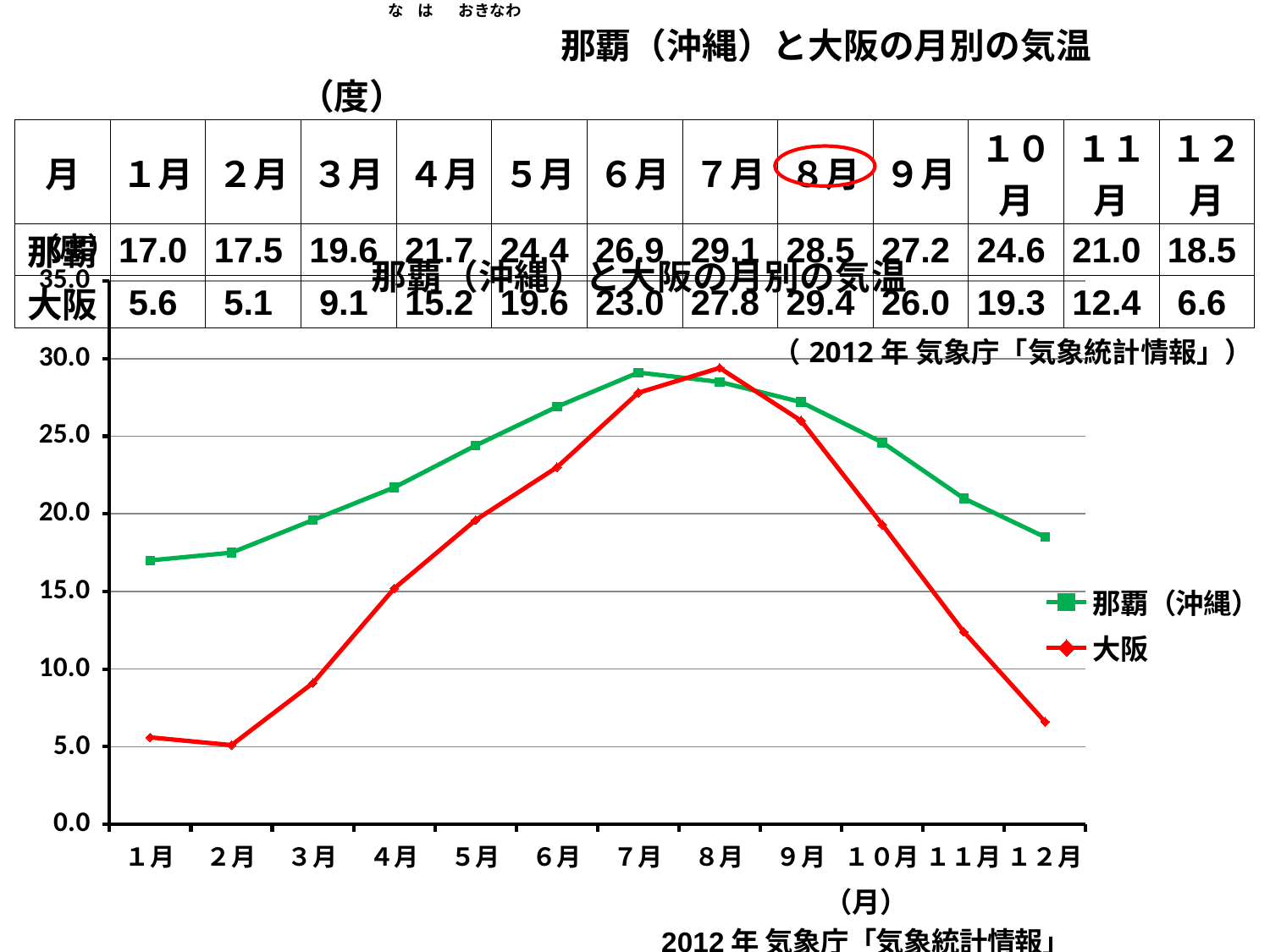
Is the 大阪 temperature in 4月 greater or less than 20.0? less What is the temperature for 大阪 in 1月? 5.6 Which series is drawn in green on the chart? 那覇（沖縄） How many series does the chart legend list? 2 Which is higher in 8月, the 那覇 temperature or the 大阪 temperature? 大阪 What is the difference between the 那覇 and 大阪 temperatures in 1月? 11.4 What is the temperature for 大阪 in 8月? 29.4 How many months are plotted along the x axis of the chart? 12 In which month is the 大阪 temperature lowest? 2月 In which month is the 那覇 temperature highest? 7月 What kind of chart is shown on the slide? line chart What is the temperature for 那覇 in 8月? 28.5